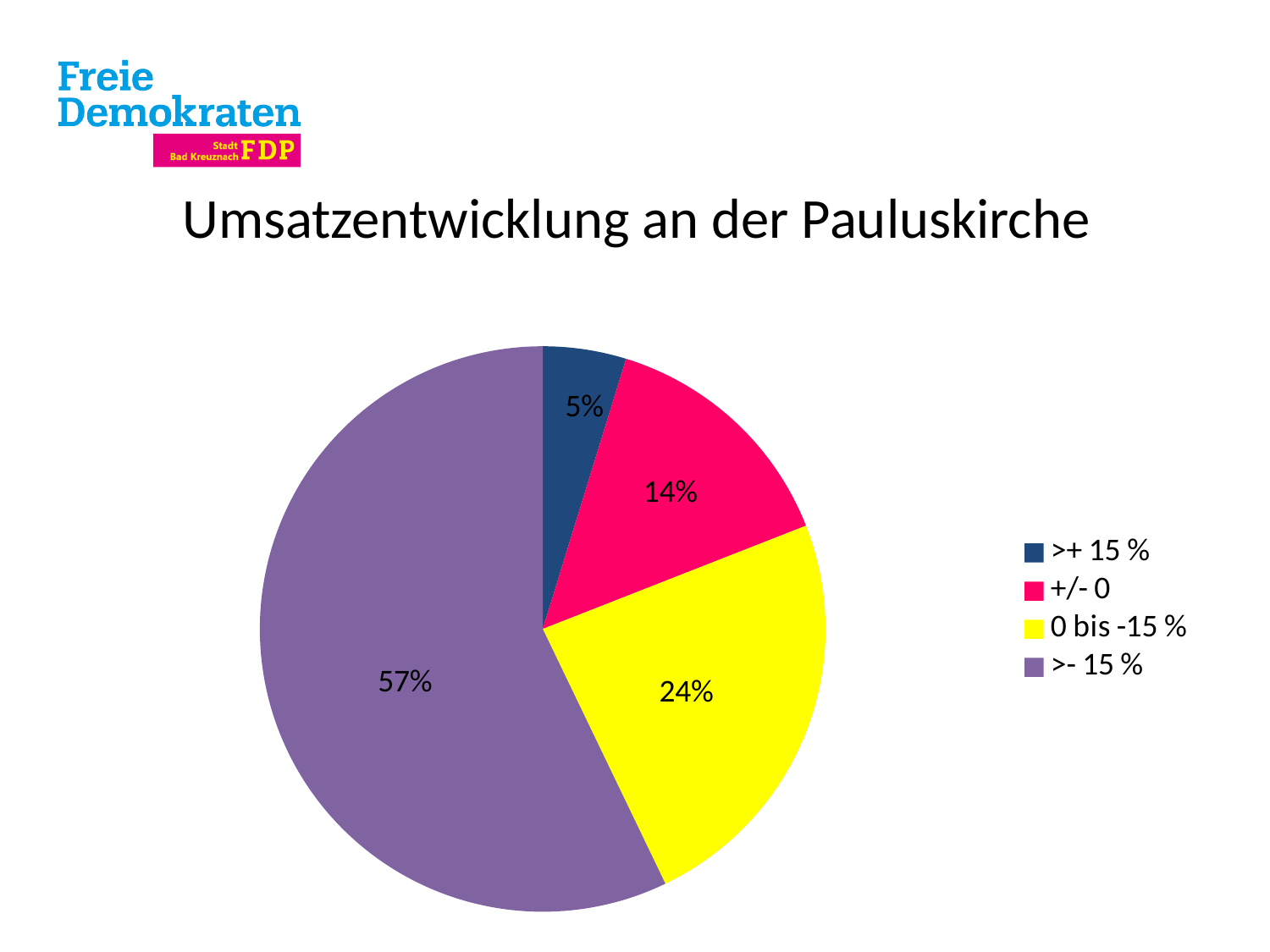
Which category has the largest slice of the pie? >- 15 % What share of the pie does the ">- 15 %" slice represent? 57% What is the difference in percentage points between the ">- 15 %" slice and the "0 bis -15 %" slice? 33 What share of the pie does the "0 bis -15 %" slice represent? 24% Which slice is larger, "+/- 0" or "0 bis -15 %"? 0 bis -15 % Which category has the smallest slice of the pie? >+ 15 % What share of the pie does the "+/- 0" slice represent? 14% What kind of chart is shown on the slide? pie chart What is the title of the chart? Umsatzentwicklung an der Pauluskirche How many categories does the pie chart have? 4 What colour is the "0 bis -15 %" slice? yellow